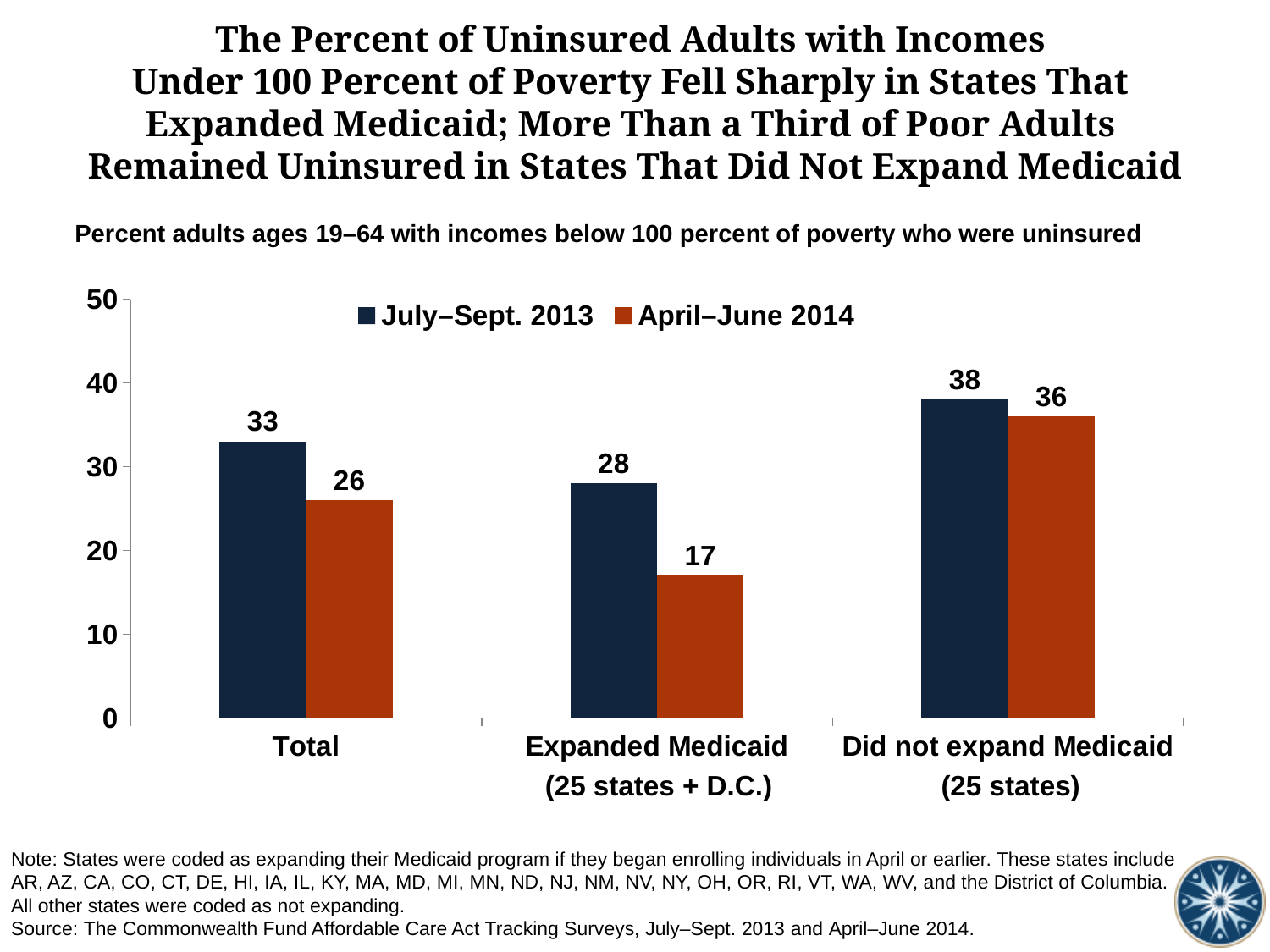
Which category has the highest value in April–June 2014? Did not expand Medicaid (25 states) What is the difference between the July–Sept. 2013 and April–June 2014 values for Total? 7 How many categories are shown on the x axis? 3 Which category has the lowest value in July–Sept. 2013? Expanded Medicaid (25 states + D.C.) What is the value for Did not expand Medicaid (25 states) in July–Sept. 2013? 38 Which is larger: the April–June 2014 value for Total or the April–June 2014 value for Expanded Medicaid (25 states + D.C.)? Total What kind of chart is shown on the slide? Bar chart What is the value for Expanded Medicaid (25 states + D.C.) in April–June 2014? 17 How many series does the legend list? 2 What is the value for Total in July–Sept. 2013? 33 What is the difference between the July–Sept. 2013 and April–June 2014 values for Expanded Medicaid (25 states + D.C.)? 11 Which series is shown in dark blue in the legend? July–Sept. 2013